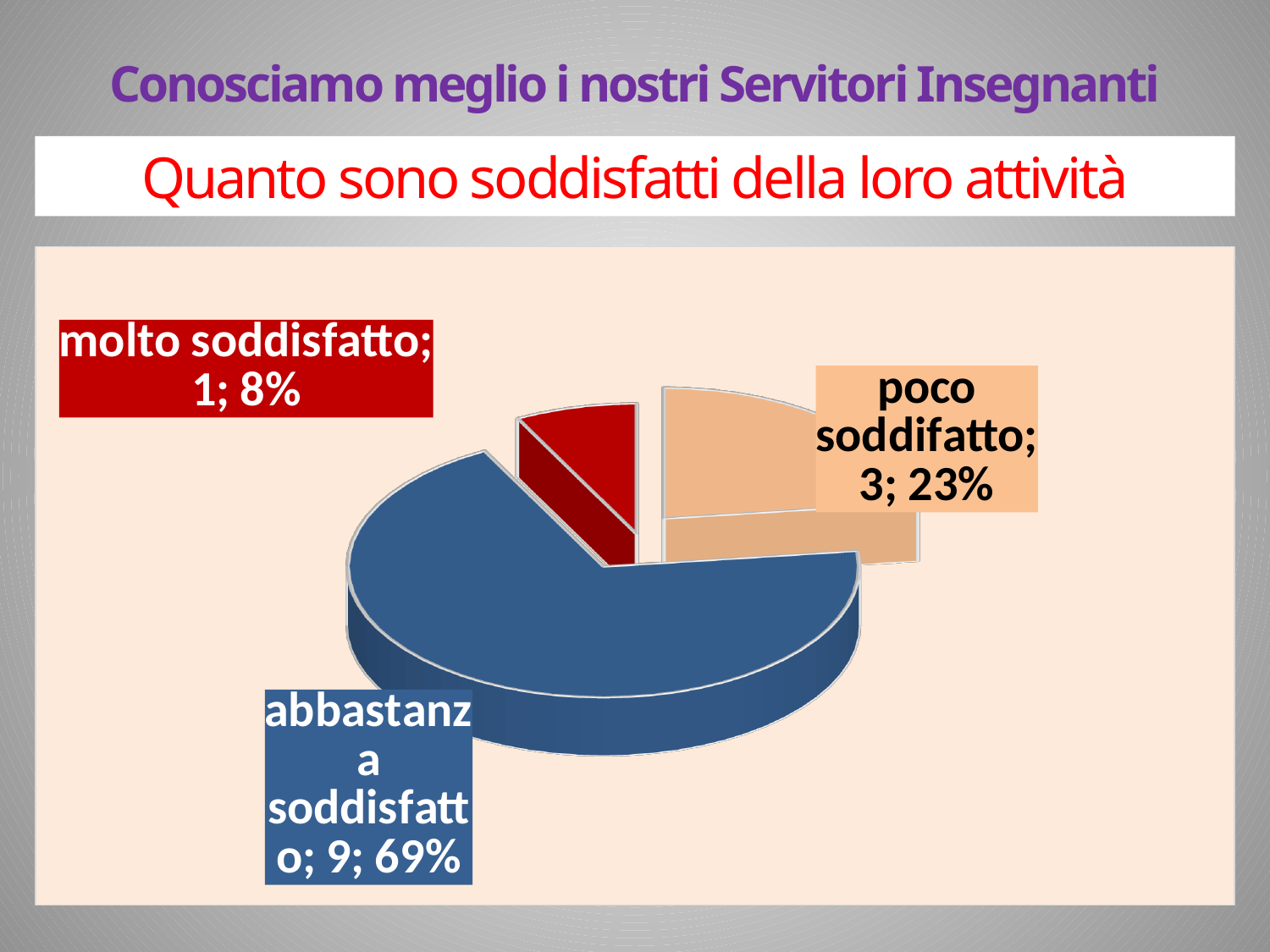
Which is larger, the count for 'poco soddifatto' or for 'molto soddisfatto'? poco soddifatto What is the count for 'molto soddisfatto'? 1 Which category has the smallest slice? molto soddisfatto What kind of chart is shown on the slide? pie chart What colour is the 'molto soddisfatto' slice? red Which category has the largest slice? abbastanza soddisfatto What is the difference in count between 'abbastanza soddisfatto' and 'poco soddifatto'? 6 What is the count for 'abbastanza soddisfatto'? 9 What percentage share does 'poco soddifatto' have? 23% What percentage share does 'abbastanza soddisfatto' have? 69% What is the total count across all slices of the pie chart? 13 How many slices does the pie chart have? 3